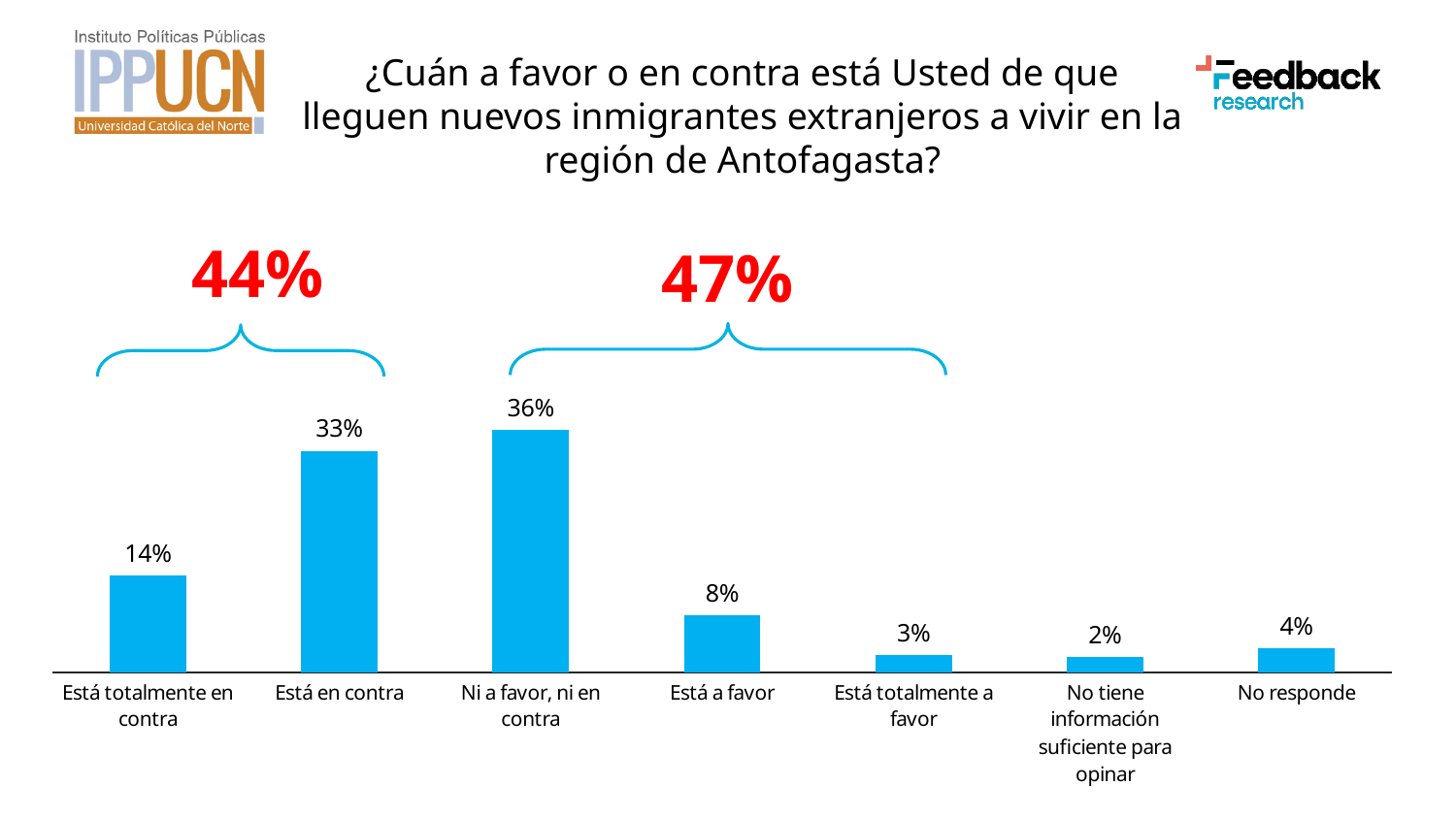
What percentage is printed in red above the bracket spanning the first two bars? 44% What is the value for "Está totalmente en contra"? 14% How many categories are shown on the x axis? 7 What percentage is printed in red above the bracket spanning the middle bars? 47% What is the value for "Ni a favor, ni en contra"? 36% Which is larger, the value for "Está totalmente en contra" or the value for "Está a favor"? Está totalmente en contra What is the difference between the values for "Está en contra" and "Está a favor"? 25% What kind of chart is shown on the slide? Bar chart What is the value for "No responde"? 4% Which category has the highest value? Ni a favor, ni en contra What is the value for "Está en contra"? 33% Which category has the lowest value? No tiene información suficiente para opinar